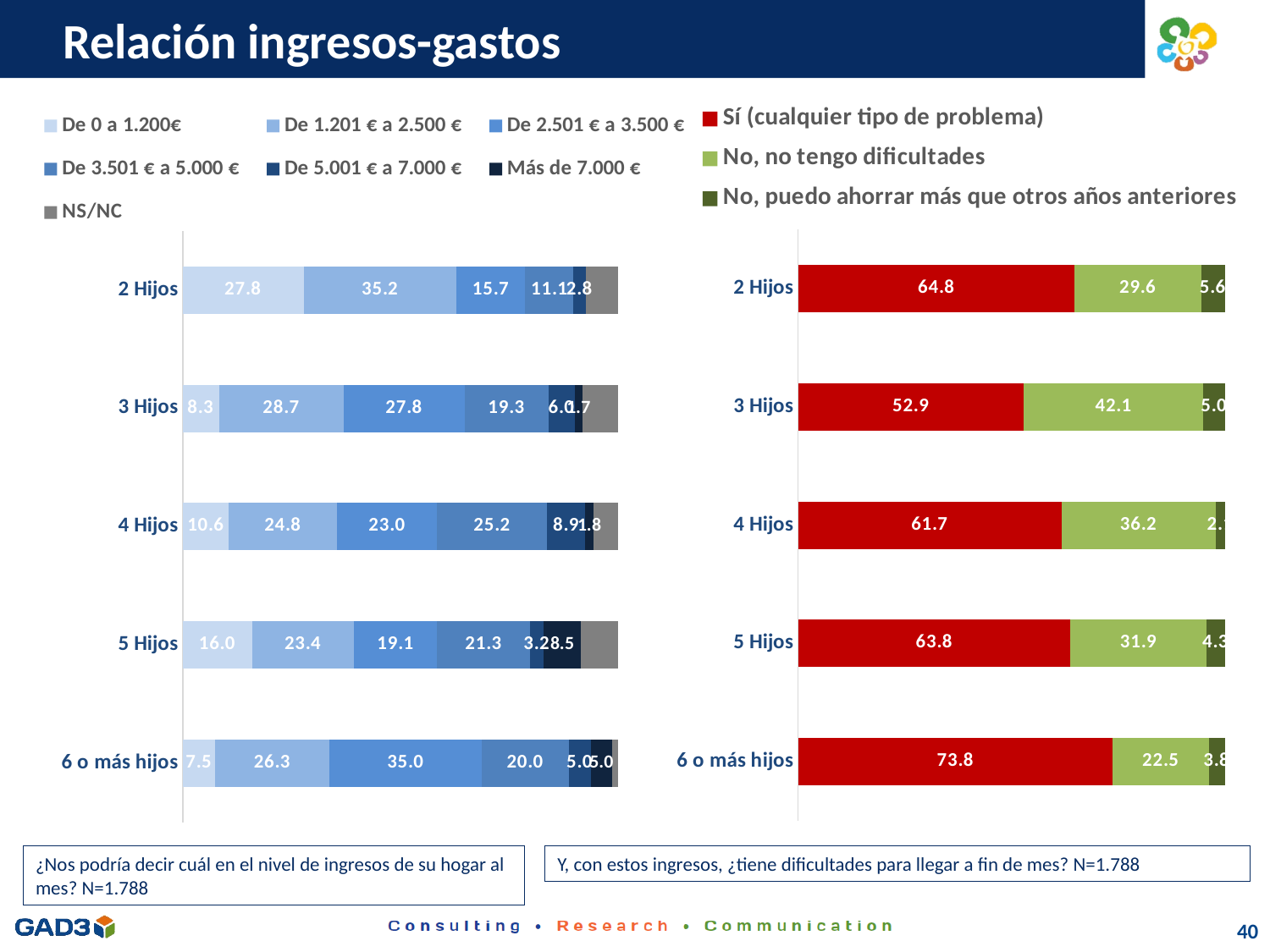
How many series does the legend of the left chart list? 7 On the left chart, what is the value of 'De 3.501 € a 5.000 €' for 4 Hijos? 25.2 On the right chart, what is the value of 'Sí (cualquier tipo de problema)' for 6 o más hijos? 73.8 On the right chart, what is the difference between the 'Sí (cualquier tipo de problema)' values for 6 o más hijos and 3 Hijos? 20.9 On the right chart, which category has the lowest value for 'Sí (cualquier tipo de problema)'? 3 Hijos On the right chart, what is the total of the stacked bar for 2 Hijos? 100.0 How many categories are shown on the left chart? 5 On the right chart, what is the value of 'No, no tengo dificultades' for 3 Hijos? 42.1 What kind of chart is the left chart? Stacked bar chart How many series does the legend of the right chart list? 3 On the right chart, which category has the highest value for 'Sí (cualquier tipo de problema)'? 6 o más hijos On the right chart, which is larger for 2 Hijos: 'Sí (cualquier tipo de problema)' or 'No, no tengo dificultades'? Sí (cualquier tipo de problema)